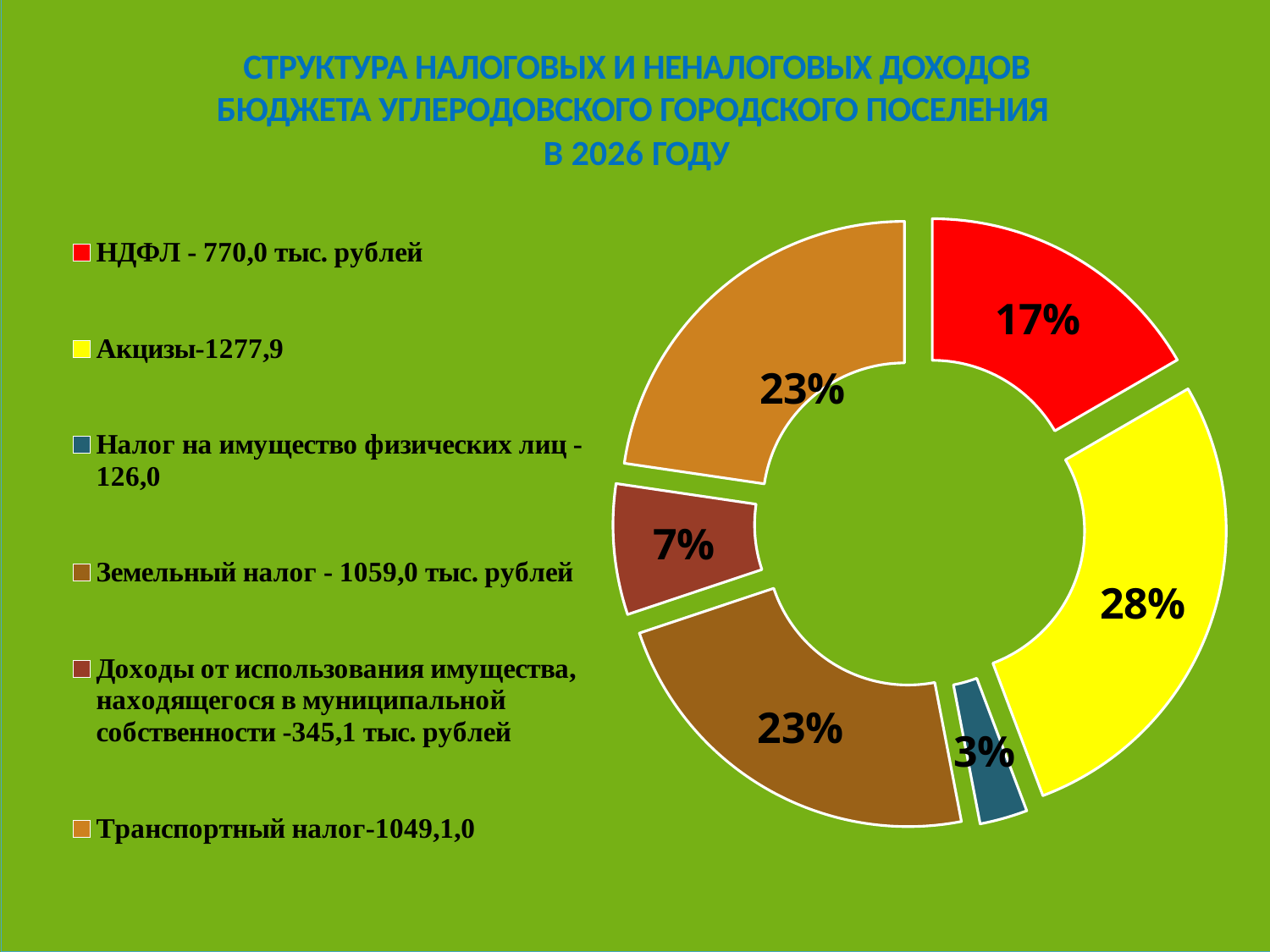
Which category has the largest share in the chart? Акцизы According to the legend, what is the amount for НДФЛ? 770,0 тыс. рублей By how many percentage points does the share of Акцизы exceed the share of НДФЛ? 11 percentage points What percentage share does Доходы от использования имущества, находящегося в муниципальной собственности have in the chart? 7% What colour is the slice for Акцизы? Yellow How many categories are shown in the chart? 6 Which category has the smallest share in the chart? Налог на имущество физических лиц What percentage share does Акцизы have in the chart? 28% What type of chart is shown on the slide? Doughnut (pie) chart What percentage share does Налог на имущество физических лиц have in the chart? 3% Which has a larger share, НДФЛ or Земельный налог? Земельный налог What percentage share does НДФЛ have in the chart? 17%